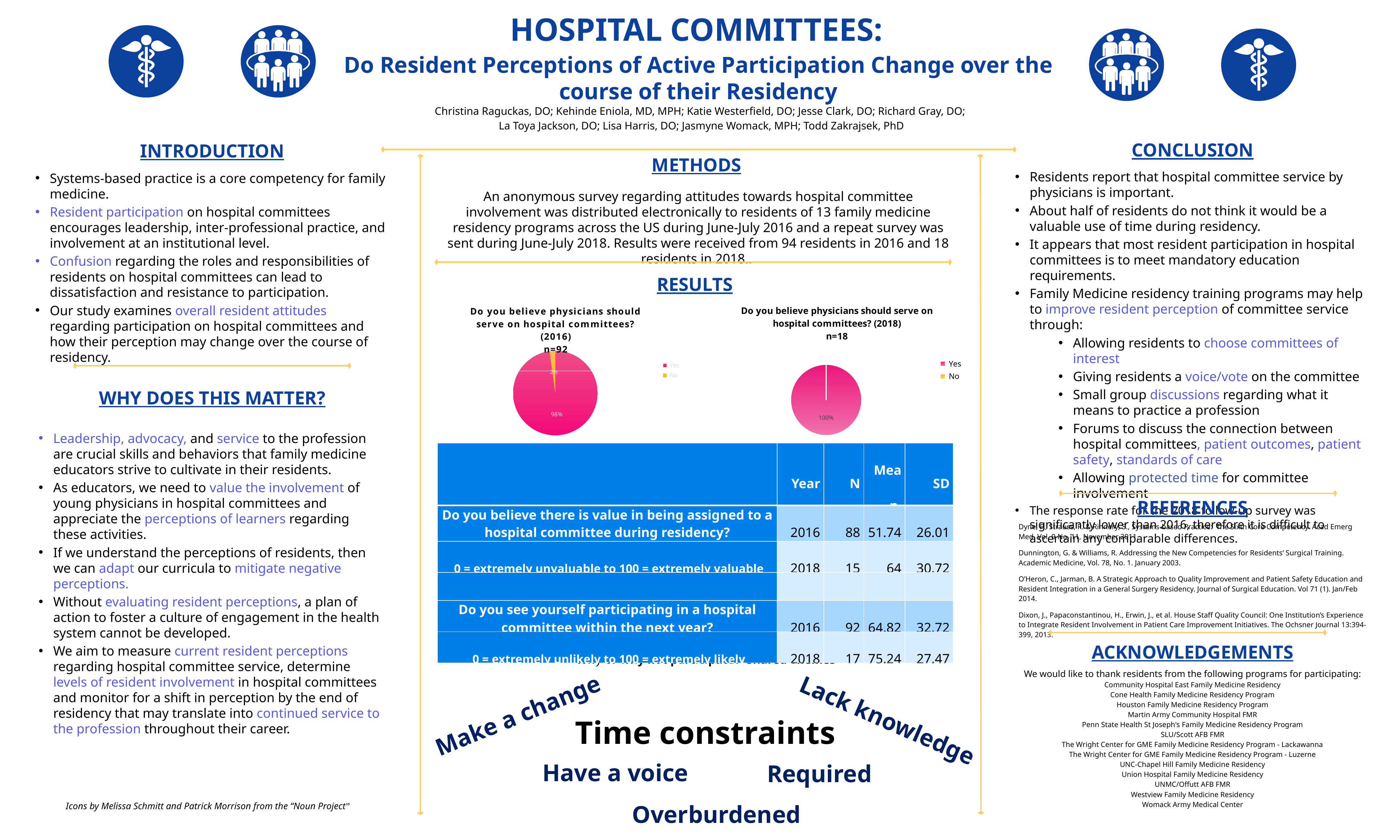
What is the sample size (n) shown in the title of the 2018 pie chart? n=18 In the 2018 pie chart 'Do you believe physicians should serve on hospital committees?', what share of respondents answered Yes? 100% Comparing the two pie charts, which year had the higher share of Yes responses, 2016 or 2018? 2018 In the 2016 pie chart, which response has the smallest slice? No What is the sample size (n) shown in the title of the 2016 pie chart? n=92 In the 2016 pie chart 'Do you believe physicians should serve on hospital committees?', what share of respondents answered No? 2% What kind of chart is used to show responses to 'Do you believe physicians should serve on hospital committees?' for 2016? pie chart In the 2016 pie chart 'Do you believe physicians should serve on hospital committees?', what share of respondents answered Yes? 98% In the 2016 pie chart, which response has the largest slice? Yes In the 2016 pie chart, what is the difference in percentage points between the Yes and No slices? 96 How many entries does the legend of the 2018 pie chart list? 2 In the 2016 pie chart, is the Yes slice larger or smaller than the No slice? larger